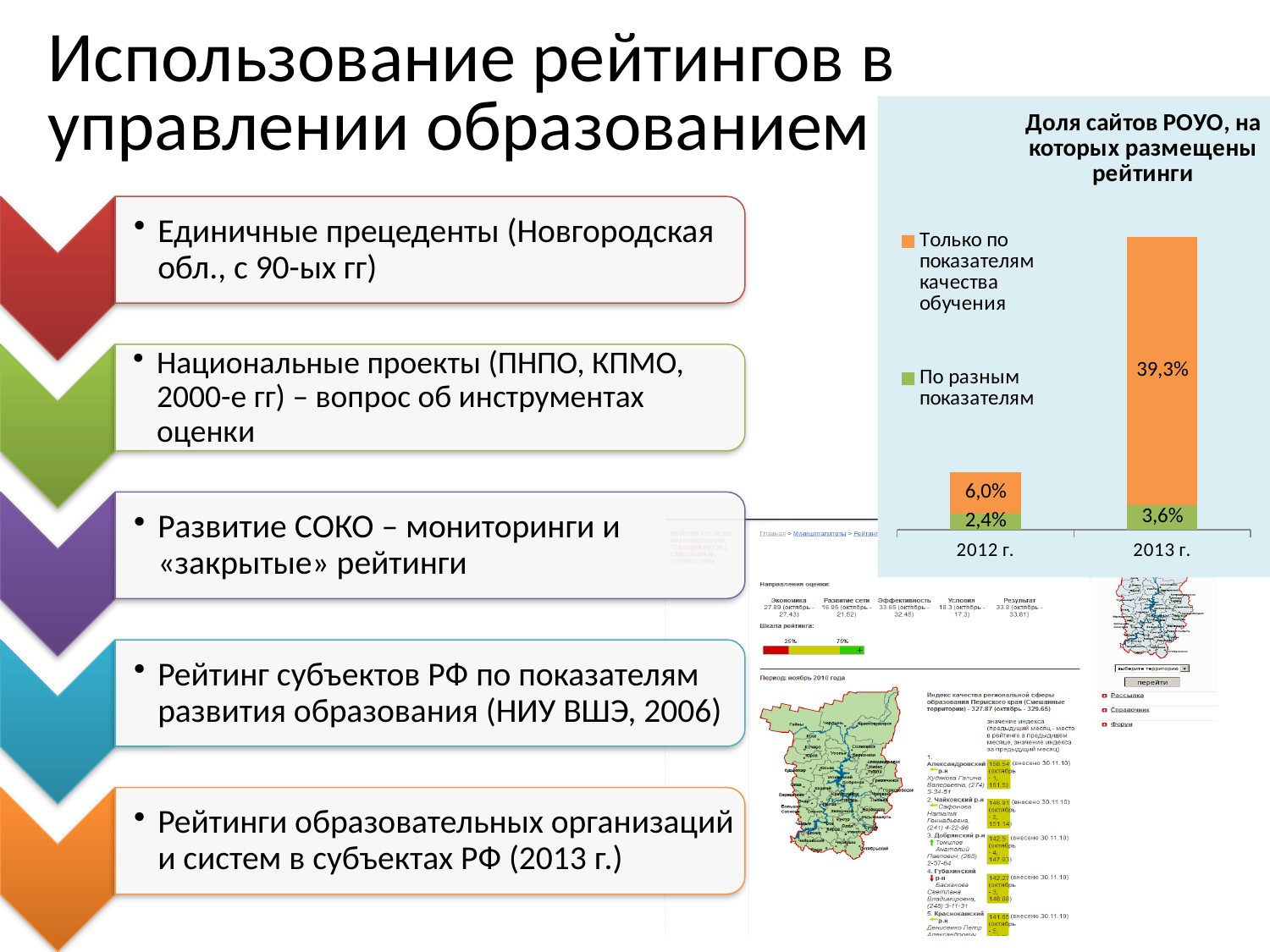
What is the total of the stacked bar for 2013 г.? 42,9% What is the value for "Только по показателям качества обучения" in 2012 г.? 6,0% What is the difference between the "Только по показателям качества обучения" values for 2013 г. and 2012 г.? 33,3% Which year has the larger value for "По разным показателям", 2012 г. or 2013 г.? 2013 г. What is the title of the chart on the slide? Доля сайтов РОУО, на которых размещены рейтинги What is the value for "Только по показателям качества обучения" in 2013 г.? 39,3% What type of chart is shown on the slide? stacked bar chart What is the value for "По разным показателям" in 2012 г.? 2,4% What is the value for "По разным показателям" in 2013 г.? 3,6% How many categories are shown on the x axis of the chart? 2 What is the total of the stacked bar for 2012 г.? 8,4% How many series does the chart legend list? 2